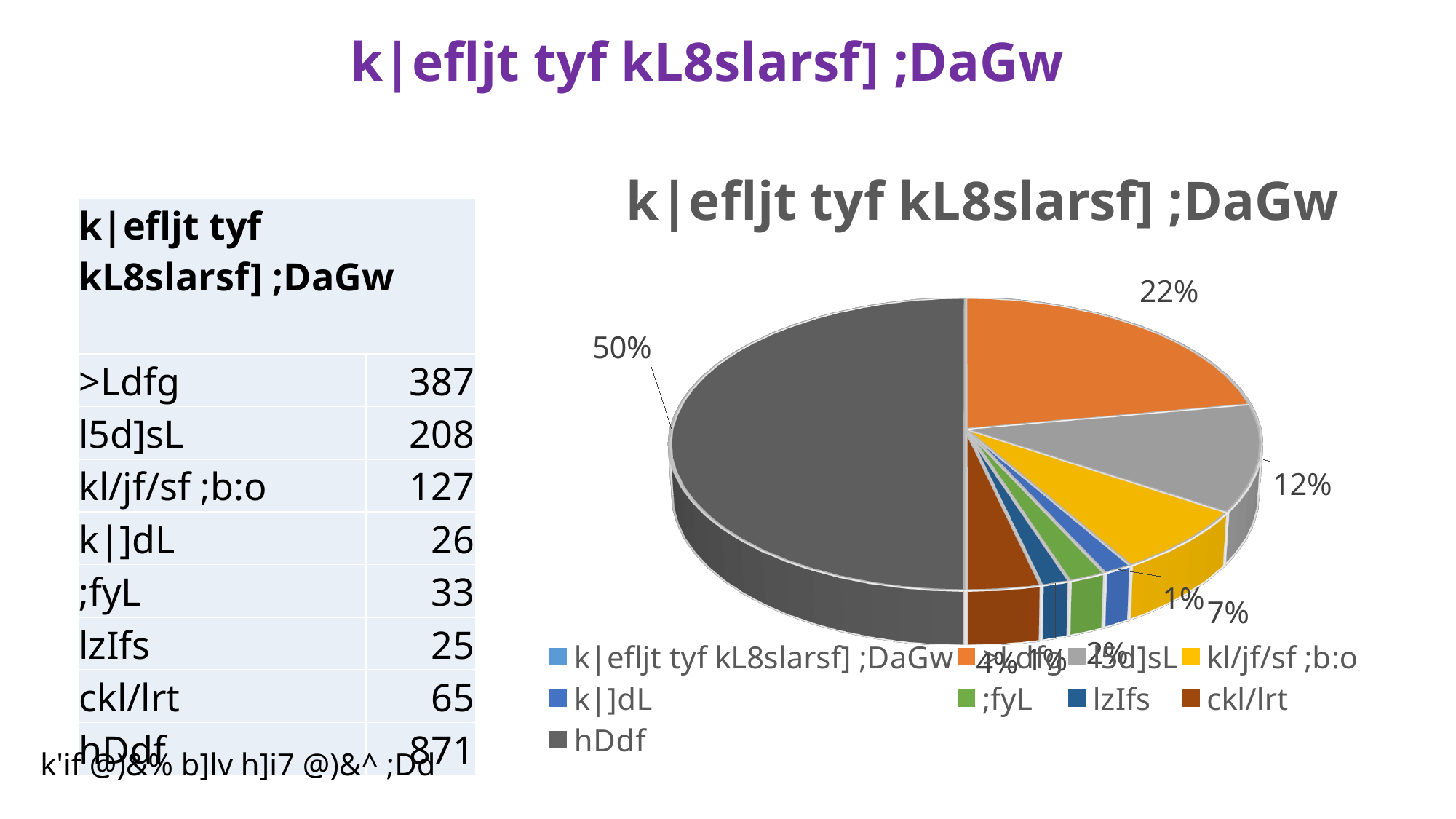
What kind of chart is shown on the slide? pie chart Which slice is larger, >Ldfg or l5d]sL? >Ldfg What percentage is shown for the orange slice (>Ldfg)? 22% How many entries does the chart legend list? 9 Which slice is larger, the orange slice or the yellow slice? the orange slice What percentage is shown for the yellow slice (kl/jf/sf ;b:o)? 7% What percentage is shown for the largest slice (hDdf)? 50% What is the difference in percentage points between the >Ldfg slice (22%) and the l5d]sL slice (12%)? 10 What percentage is shown for the gray slice (l5d]sL)? 12% Which category has the largest slice of the pie? hDdf What is the title of the chart? k|efljt tyf kL8slarsf] ;DaGw What colour is the largest slice of the pie? dark gray